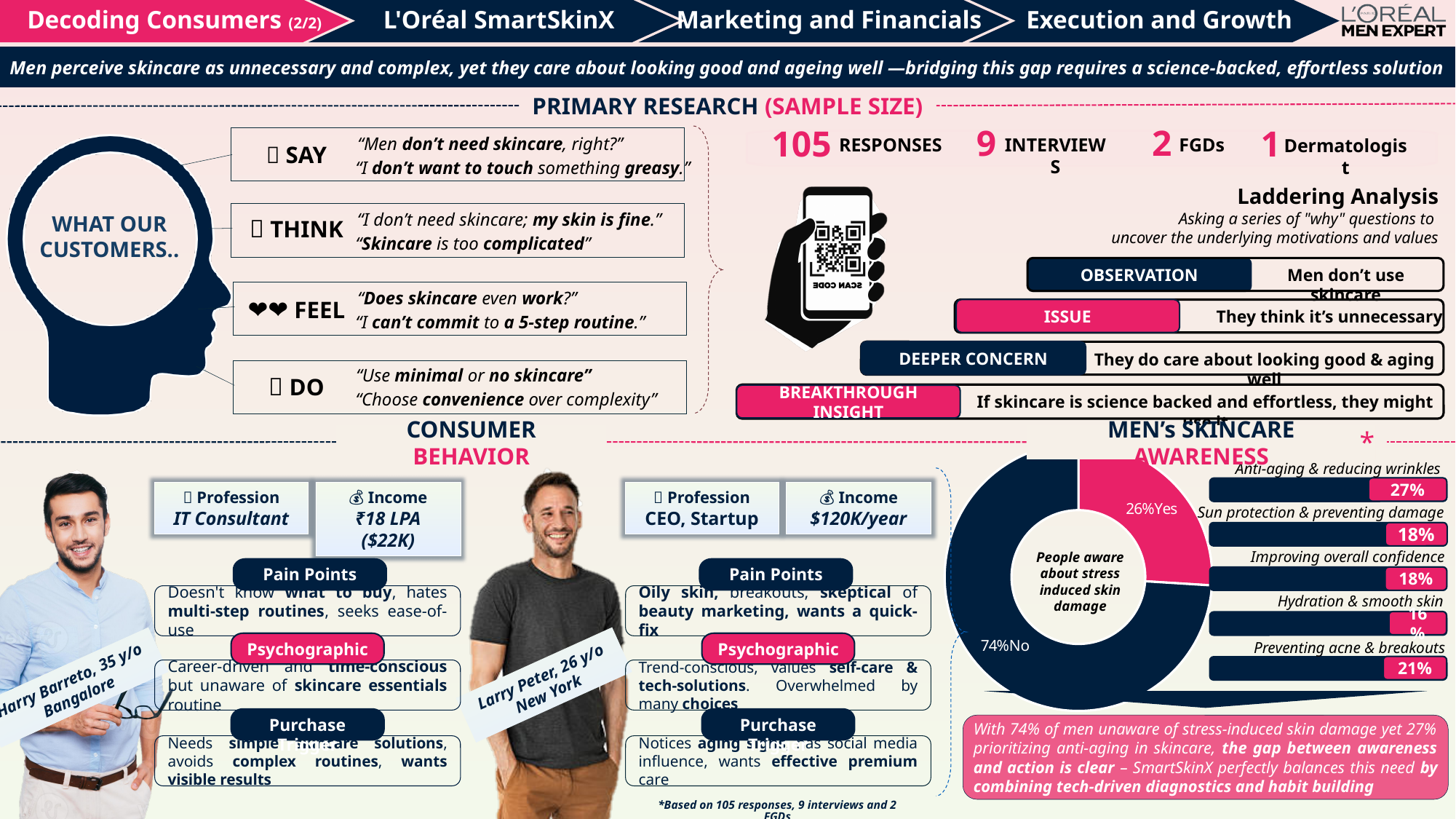
In the Men's Skincare Awareness bars, which category has the lowest value? Hydration & smooth skin In the Men's Skincare Awareness bars, what is the value for Anti-aging & reducing wrinkles? 27% In the donut chart under Men's Skincare Awareness, what percentage of men answered Yes to being aware of stress-induced skin damage? 26% In the Men's Skincare Awareness bars, what is the difference between Anti-aging & reducing wrinkles and Sun protection & preventing damage? 9% In the Men's Skincare Awareness bars, which category has the highest value? Anti-aging & reducing wrinkles How many slices does the donut chart about stress-induced skin damage awareness have? 2 In the donut chart under Men's Skincare Awareness, what percentage of men answered No? 74% In the donut chart, what is the difference between the No share and the Yes share? 48% In the Men's Skincare Awareness bars, what is the value for Preventing acne & breakouts? 21% What kind of chart shows the share of people aware about stress-induced skin damage? Donut (pie) chart In the donut chart, which response is larger, Yes or No? No How many categories are listed in the Men's Skincare Awareness bars? 5